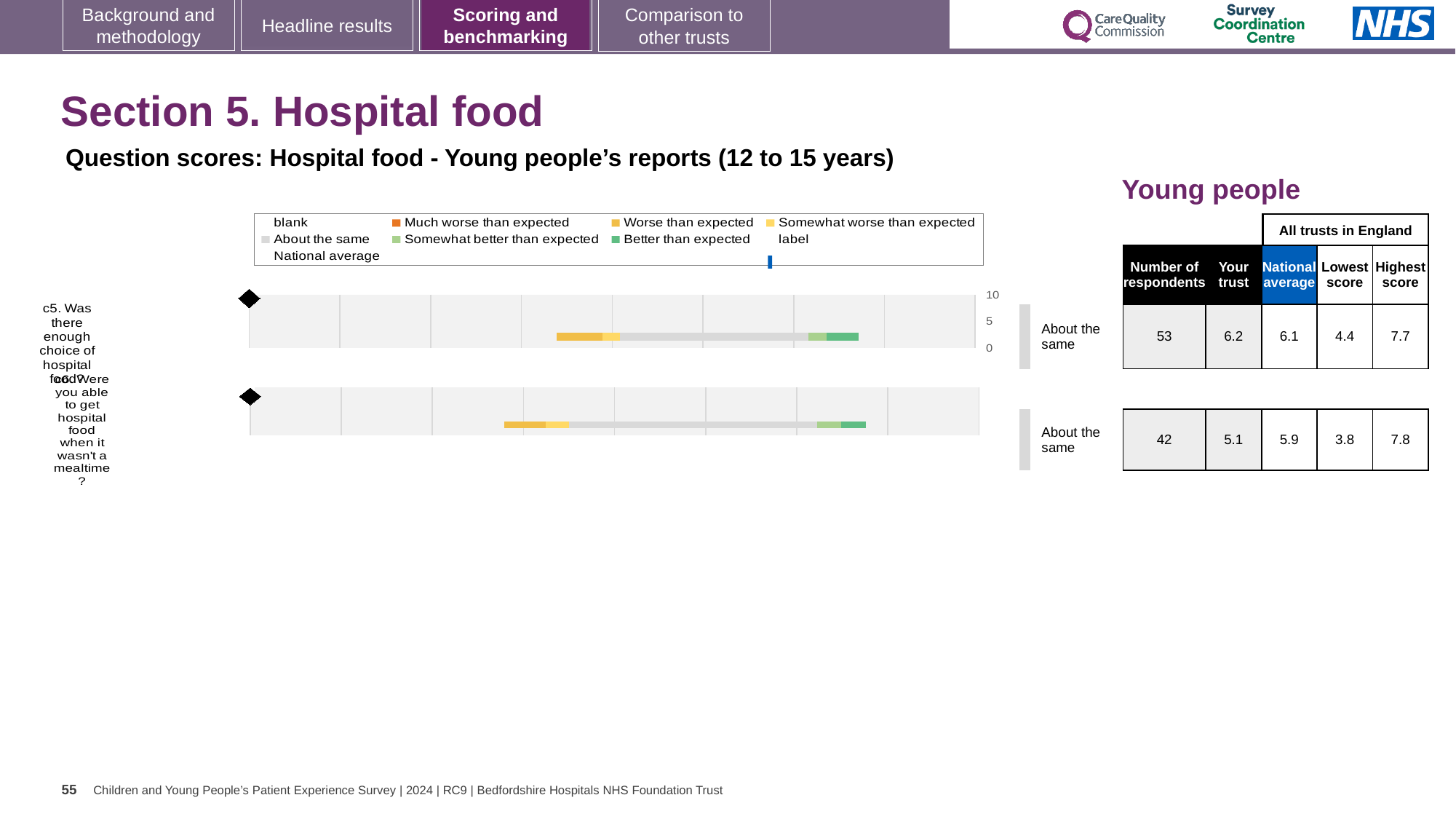
What kind of chart is used to show the question scores for hospital food? bar chart How many questions are plotted in the hospital food chart? 2 Which question has the higher 'Your trust' score in the table, c5 or c6? c5 What benchmark category is shown next to the bar for question c5 (enough choice of hospital food)? About the same In the table beside the chart, what is the lowest score among all trusts in England for c6? 3.8 In the table beside the chart, how many respondents answered c6 (able to get hospital food when it wasn't a mealtime)? 42 In the table beside the chart, what is the 'Your trust' score for c5 (enough choice of hospital food)? 6.2 What is the highest tick value shown on the chart's score axis? 10 Which question has more respondents in the table, c5 or c6? c5 In the table beside the chart, what is the national average score for c6 (able to get hospital food when it wasn't a mealtime)? 5.9 By how much does the trust's score for c5 (6.2) exceed the national average (6.1) in the table? 0.1 What is the difference between the highest score (7.7) and the lowest score (4.4) for c5 in the table? 3.3